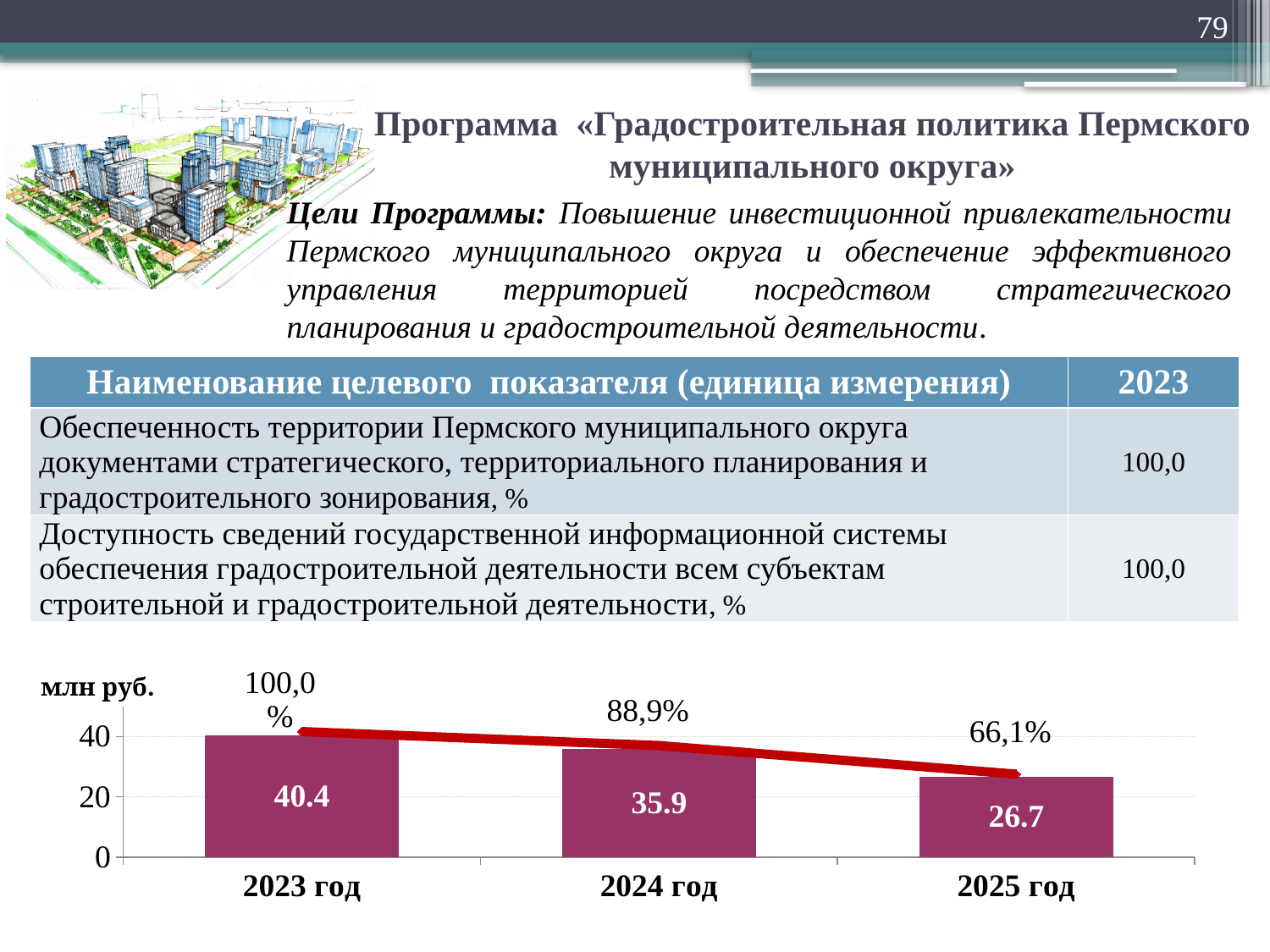
What is the value for 2025 год in the bar chart? 26.7 Which year has the highest value in the bar chart? 2023 год Which is larger in the bar chart, the value for 2024 год or the value for 2025 год? 2024 год What kind of chart is shown at the bottom of the slide? combination bar and line chart What is the difference between the values for 2023 год and 2025 год in the bar chart? 13.7 What is the value for 2023 год in the bar chart? 40.4 Do the values in the bar chart rise or fall from 2023 год to 2025 год? fall Is the value for 2023 год in the bar chart greater or less than 40? greater How many years are shown in the bar chart? 3 Which year has the lowest value in the bar chart? 2025 год What is the value for 2024 год in the bar chart? 35.9 What percentage label is shown above the 2025 год bar in the chart? 66,1%